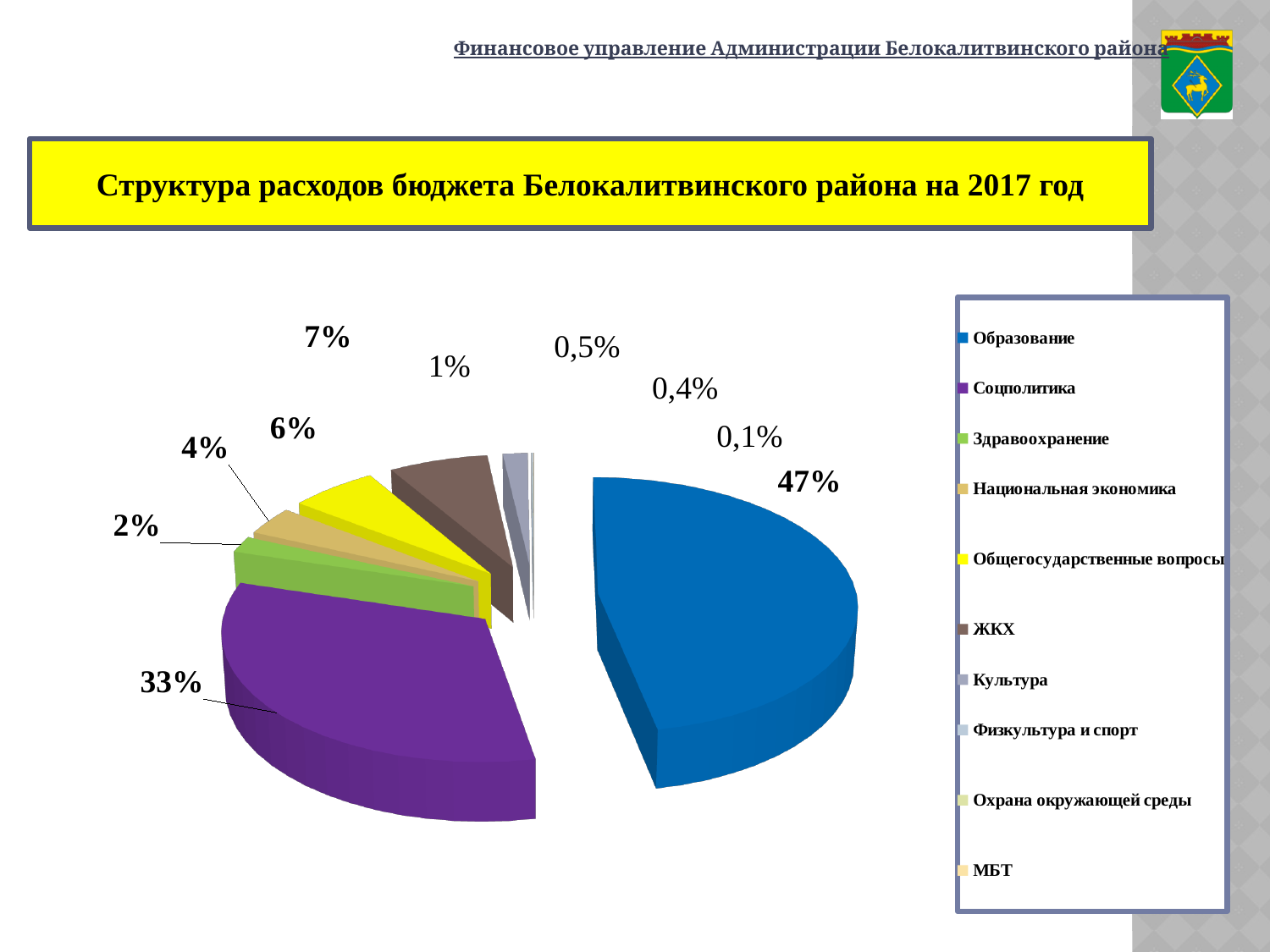
How many categories does the legend list? 10 What type of chart is shown on the slide? pie chart What is the title of the chart on the slide? Структура расходов бюджета Белокалитвинского района на 2017 год What share of the 2017 budget expenditure goes to Соцполитика? 33% What share of the 2017 budget expenditure goes to ЖКХ? 7% Which has a larger share, Образование or Соцполитика? Образование What colour is the slice for Образование? blue What share of the 2017 budget expenditure goes to Образование? 47% Which category has the largest share of the budget expenditure? Образование What is the difference in percentage points between the shares of Образование and Соцполитика? 14 What is the combined share of Образование and Соцполитика? 80%